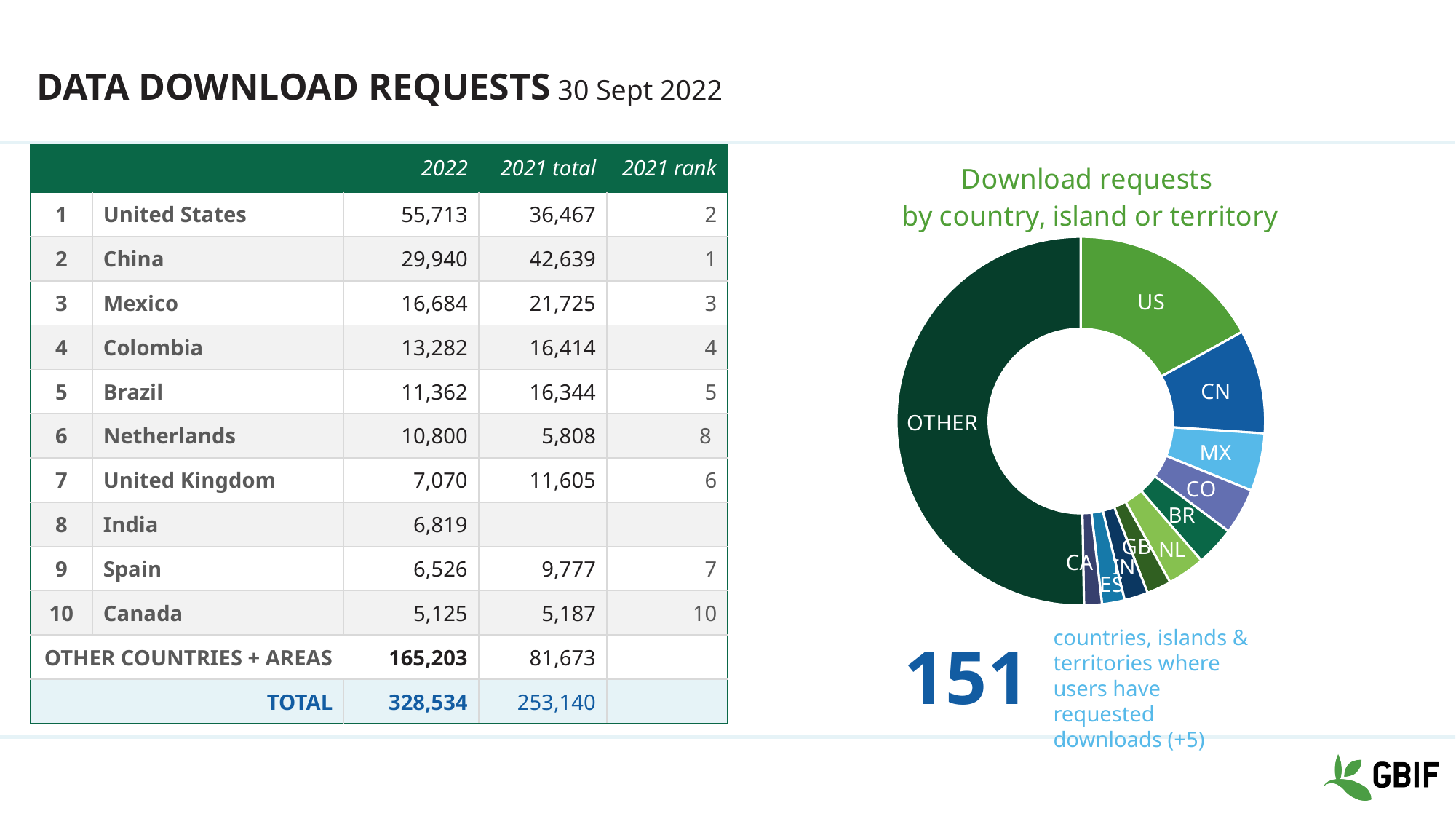
What is the title of the donut chart? Download requests by country, island or territory How many slices are labelled in the donut chart? 11 What kind of chart is shown on the right of the slide? Donut (pie) chart How many download requests in 2022 does the US slice of the donut chart represent, according to the table on the slide? 55,713 Which labelled slice of the donut chart is the smallest? CA Among the individual country slices in the donut chart (excluding OTHER), which is the largest? US What is the difference in 2022 download requests between the US and CN slices, using the values in the table on the slide? 25,773 How many download requests in 2022 does the OTHER slice of the donut chart represent, according to the table on the slide? 165,203 In the donut chart, is the US slice larger or smaller than the CN slice? larger In the donut chart, is the BR slice larger or smaller than the CN slice? smaller What number is shown in large blue text below the donut chart? 151 Which slice of the donut chart is the largest? OTHER